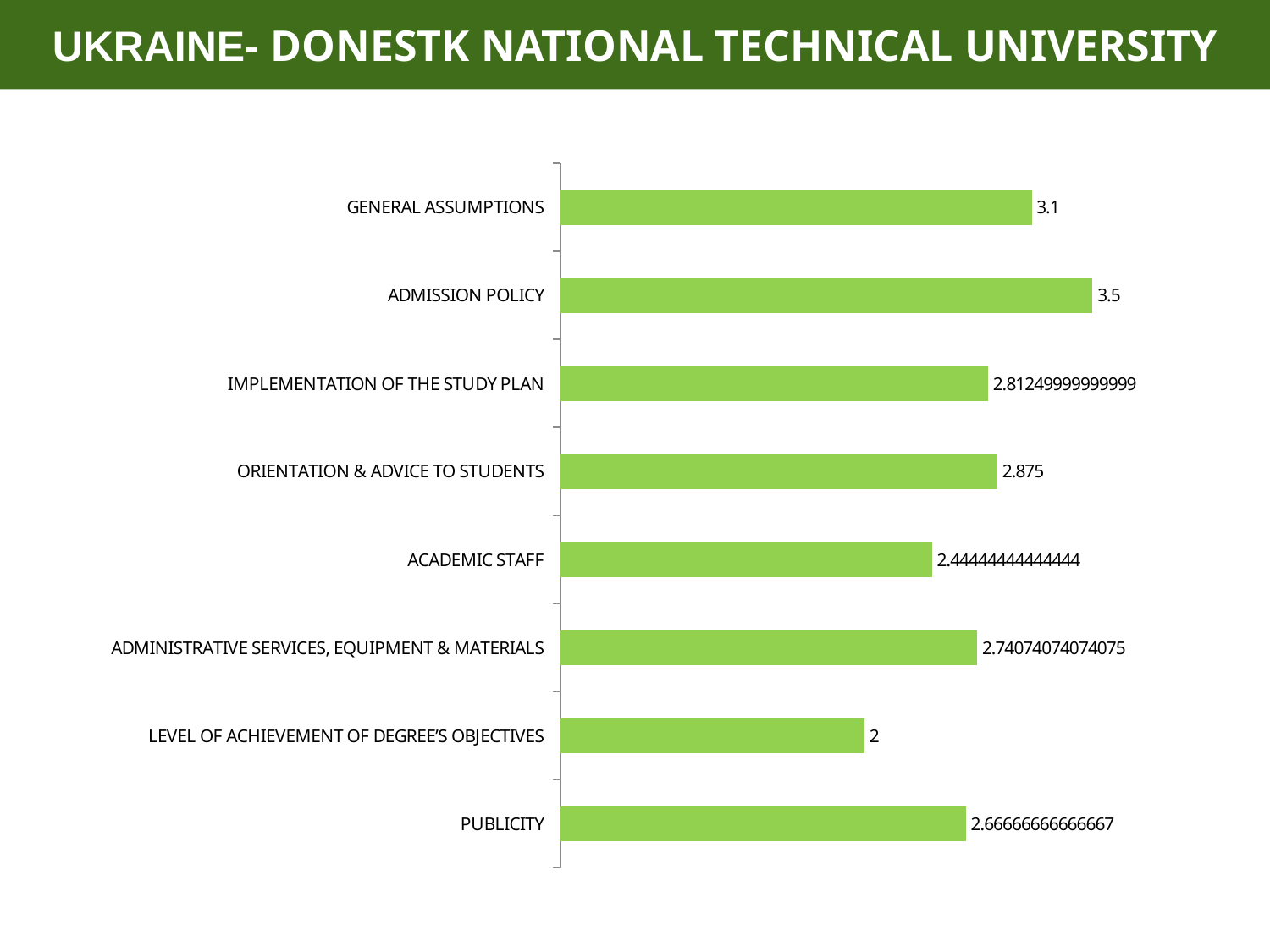
What is the value for ADMISSION POLICY? 3.5 What kind of chart is shown on the slide? Bar chart Which is larger, the value for ACADEMIC STAFF or the value for PUBLICITY? PUBLICITY What is the value for LEVEL OF ACHIEVEMENT OF DEGREE'S OBJECTIVES? 2 What is the value for GENERAL ASSUMPTIONS? 3.1 What is the difference between the values for ADMISSION POLICY and GENERAL ASSUMPTIONS? 0.4 What is the value for ORIENTATION & ADVICE TO STUDENTS? 2.875 What is the value for PUBLICITY? 2.66666666666667 How many categories are shown in the chart? 8 Which category has the highest value? ADMISSION POLICY What is the difference between the values for GENERAL ASSUMPTIONS and LEVEL OF ACHIEVEMENT OF DEGREE'S OBJECTIVES? 1.1 Which category has the lowest value? LEVEL OF ACHIEVEMENT OF DEGREE'S OBJECTIVES